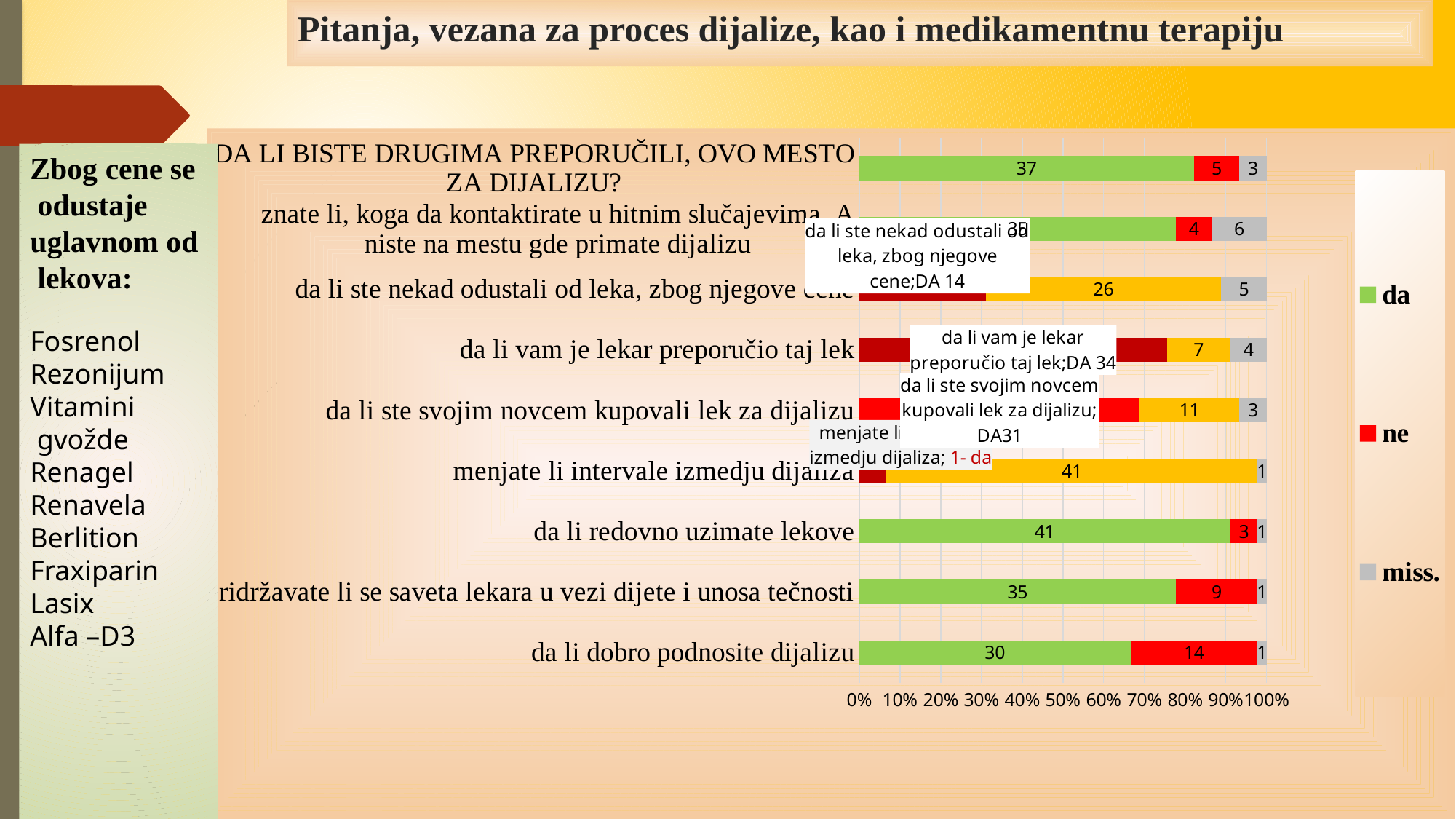
What are the series names listed in the chart legend? da, ne, miss. How many question categories are plotted on the chart? 9 What is the total of the stacked bar for 'da li dobro podnosite dijalizu'? 45 What is the 'miss.' value for 'znate li, koga da kontaktirate u hitnim slučajevima, A niste na mestu gde primate dijalizu'? 6 Which is larger for 'da li dobro podnosite dijalizu': the 'da' value or the 'ne' value? da How many series does the chart legend list? 3 What kind of chart is shown on the slide? bar chart What is the 'da' value for 'da li redovno uzimate lekove'? 41 What is the difference between the 'da' and 'ne' values for 'pridržavate li se saveta lekara u vezi dijete i unosa tečnosti'? 26 According to the callout label, what is the 'DA' value for 'da li vam je lekar preporučio taj lek'? 34 What is the 'da' value for 'DA LI BISTE DRUGIMA PREPORUČILI, OVO MESTO ZA DIJALIZU?'? 37 What is the 'ne' value for 'da li dobro podnosite dijalizu'? 14